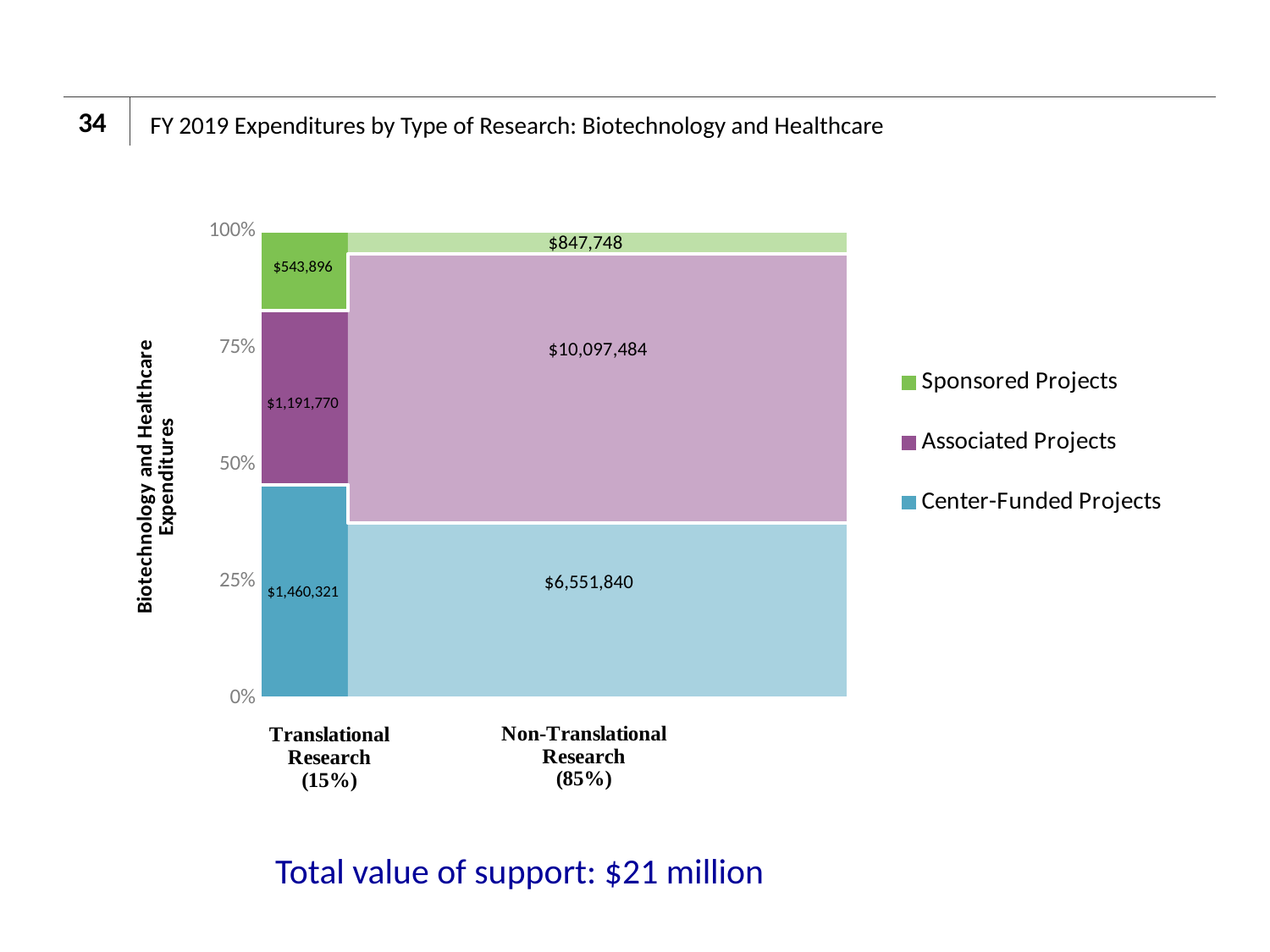
Which is larger: the Sponsored Projects value for Translational Research or for Non-Translational Research? Non-Translational Research What kind of chart is shown on the slide? Stacked bar chart What is the Associated Projects value for Non-Translational Research? $10,097,484 What is the Sponsored Projects value for Non-Translational Research? $847,748 What is the difference between the Center-Funded Projects values for Non-Translational Research and Translational Research? $5,091,519 What is the total of the three values shown for Translational Research? $3,195,987 How many series does the legend list? 3 What percentage share is shown for Non-Translational Research in its axis label? 85% What is the Center-Funded Projects value for Translational Research? $1,460,321 What is the Associated Projects value for Translational Research? $1,191,770 Which series has the largest value within Non-Translational Research? Associated Projects Which series has the smallest value within Translational Research? Sponsored Projects